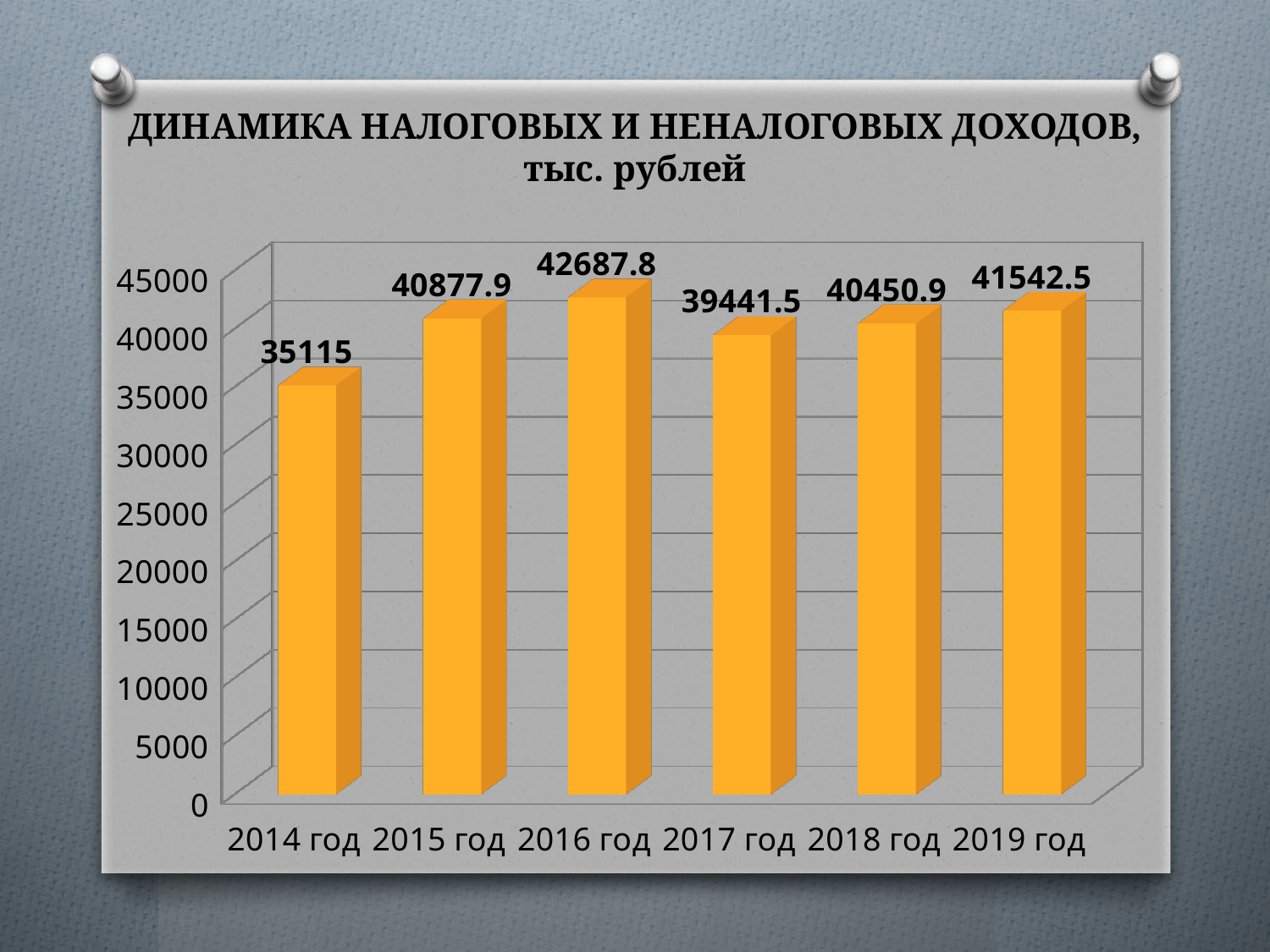
What is the title of the chart? ДИНАМИКА НАЛОГОВЫХ И НЕНАЛОГОВЫХ ДОХОДОВ, тыс. рублей What is the value for 2019 год? 41542.5 How many years are shown on the chart? 6 Which year has the lowest value? 2014 год What is the difference between the values for 2015 год and 2014 год? 5762.9 What is the value for 2014 год? 35115 Which year has the highest value? 2016 год What kind of chart is shown on the slide? bar chart What is the difference between the values for 2016 год and 2017 год? 3246.3 Which is larger, the value for 2018 год or the value for 2019 год? 2019 год What is the value for 2016 год? 42687.8 Is the value for 2017 год greater or less than 40000? less